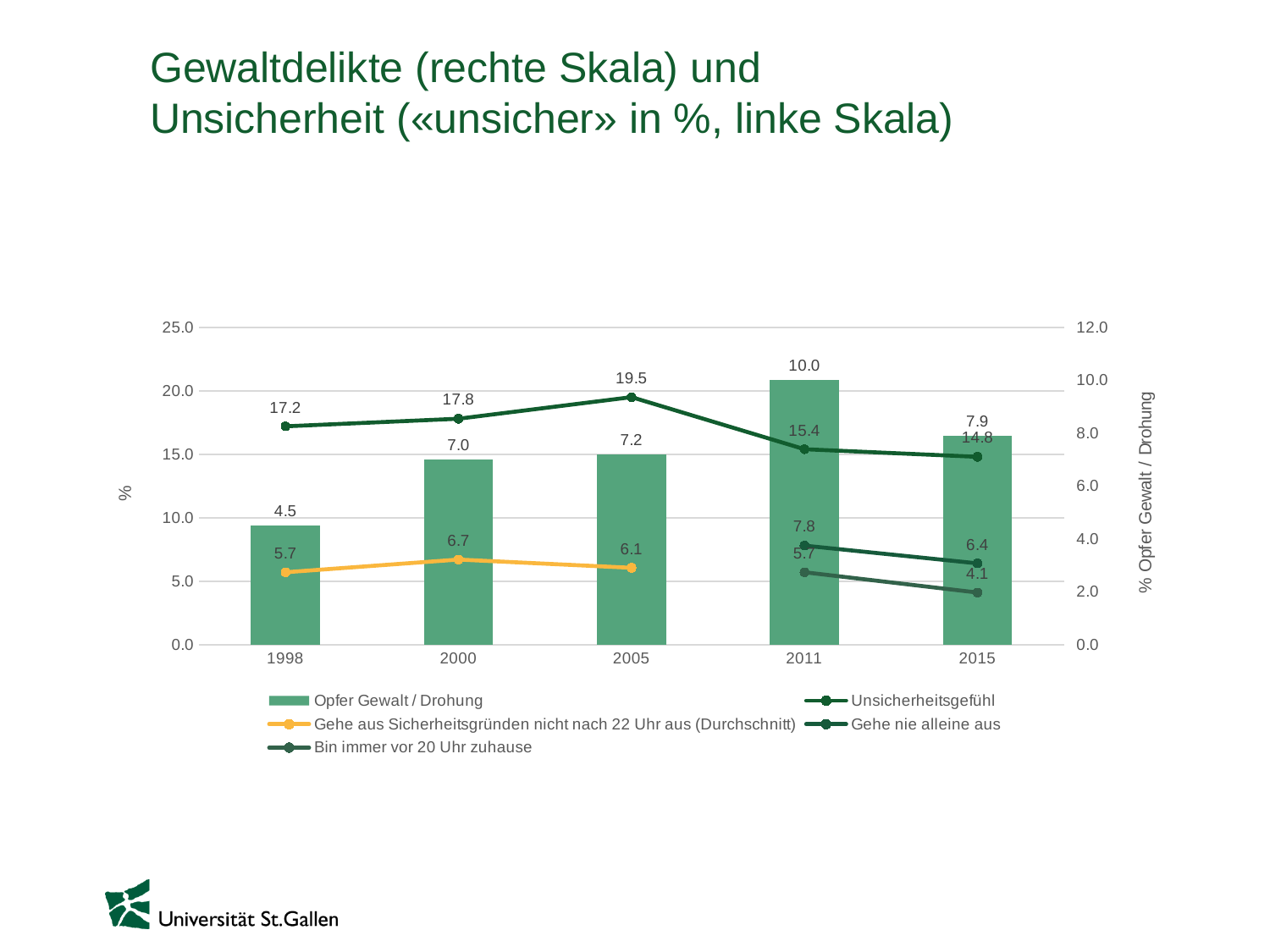
What is the value of Opfer Gewalt / Drohung in 2011? 10.0 What is the difference between the Unsicherheitsgefühl values in 2005 and 2015? 4.7 In which year is Opfer Gewalt / Drohung lowest? 1998 What is the title of the right-hand vertical axis? % Opfer Gewalt / Drohung How many series does the legend list? 5 How many years are shown on the x axis? 5 What is the value of 'Gehe aus Sicherheitsgründen nicht nach 22 Uhr aus (Durchschnitt)' in 2000? 6.7 In which year is Unsicherheitsgefühl highest? 2005 What is the value of Unsicherheitsgefühl in 2005? 19.5 Does Unsicherheitsgefühl rise or fall from 2005 to 2015? Fall What kind of chart is shown on the slide? Combined bar and line chart In 2011, which is larger: 'Gehe nie alleine aus' or 'Bin immer vor 20 Uhr zuhause'? Gehe nie alleine aus